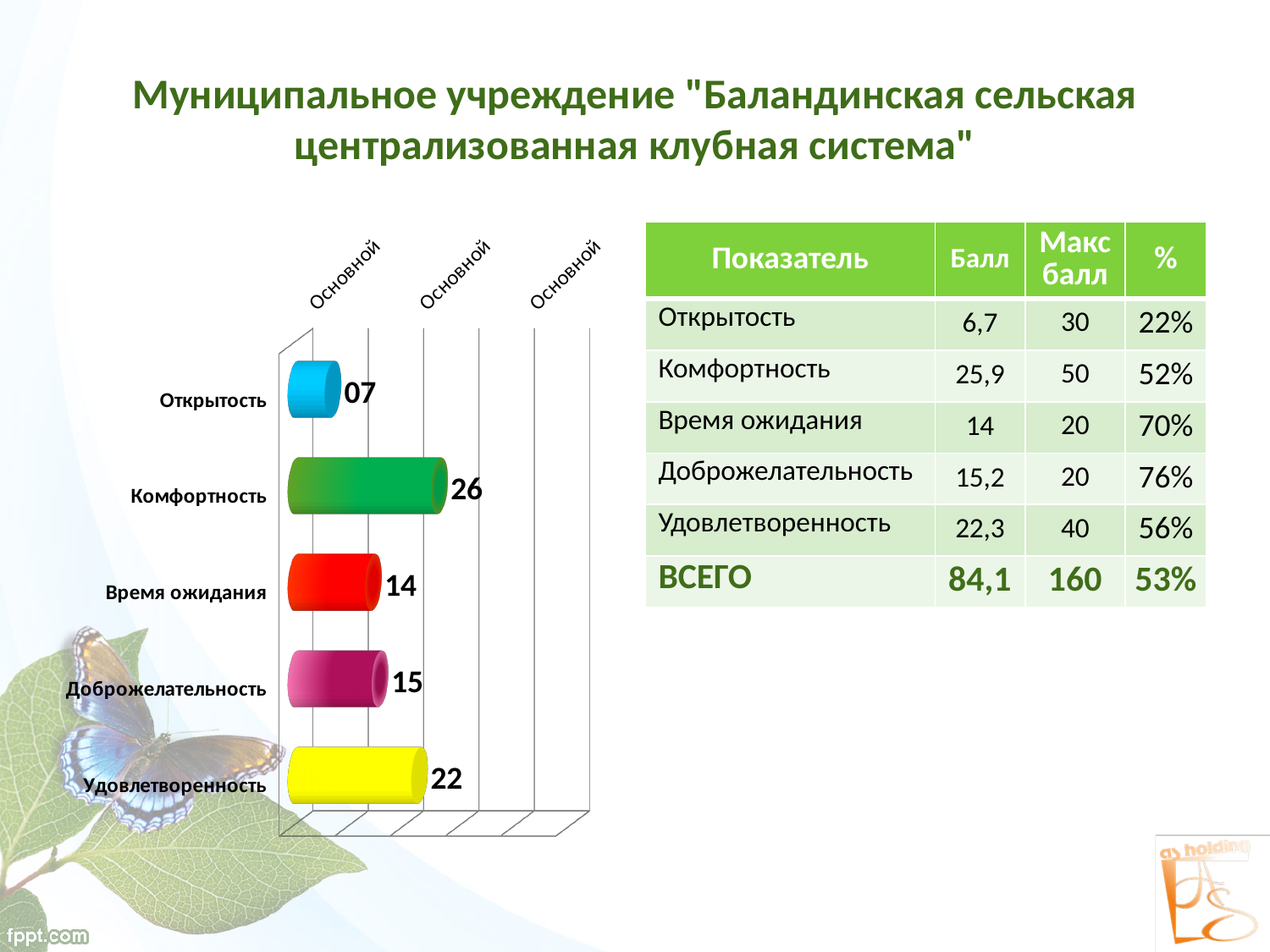
What value is shown for Открытость in the bar chart? 07 How many categories are shown in the bar chart? 5 What value is shown for Доброжелательность in the bar chart? 15 Which is larger in the bar chart, the value for Доброжелательность or the value for Время ожидания? Доброжелательность What is the difference between the values for Комфортность and Удовлетворенность in the bar chart? 4 What colour is the bar for Удовлетворенность in the chart? yellow What value is shown for Удовлетворенность in the bar chart? 22 What value is shown for Комфортность in the bar chart? 26 What type of chart is shown on the slide? bar chart Which category has the highest value in the bar chart? Комфортность Which category has the lowest value in the bar chart? Открытость What value is shown for Время ожидания in the bar chart? 14